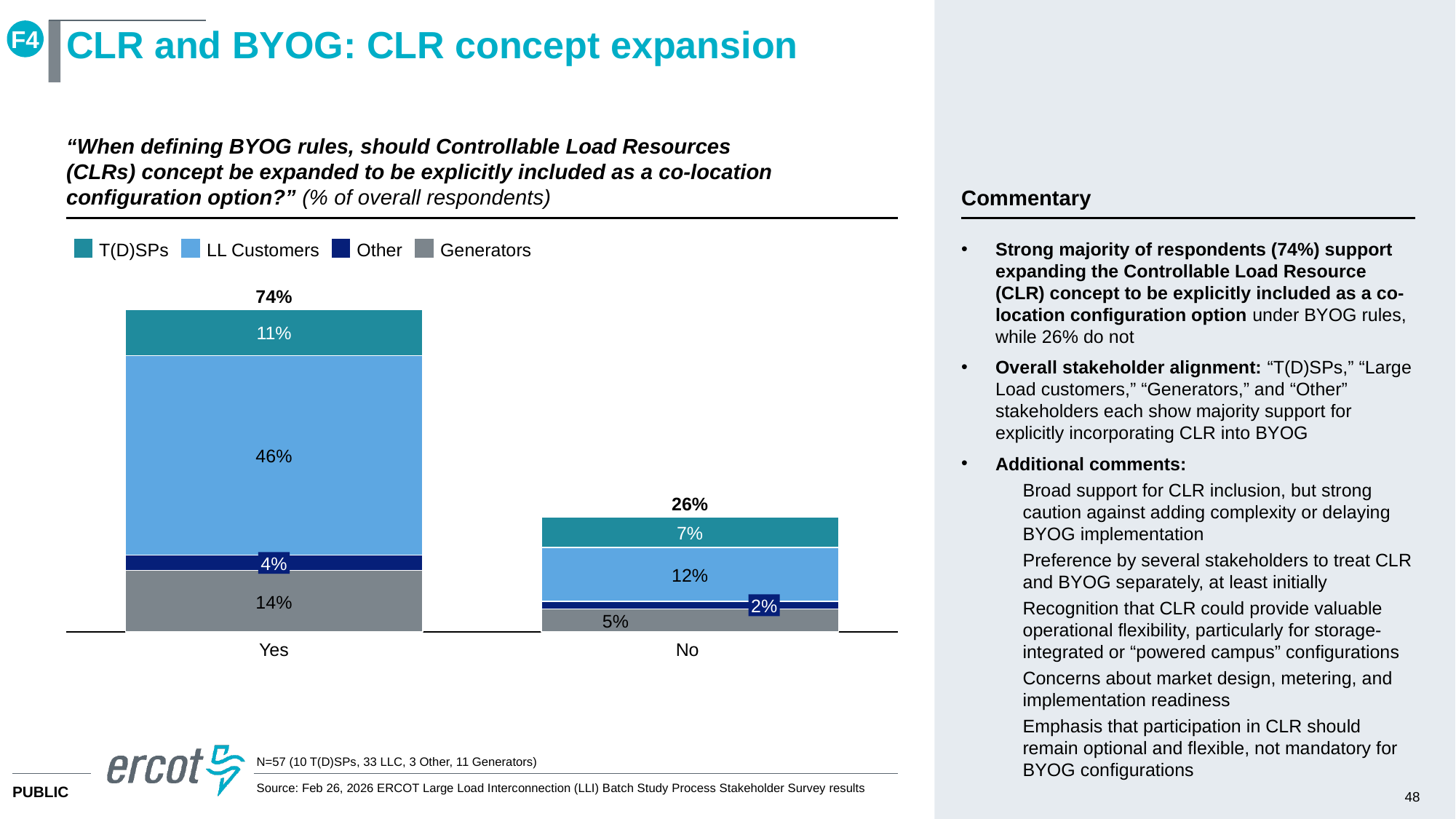
How many response categories are shown on the x axis? 2 How many series does the legend list? 4 What is the T(D)SPs value in the "No" bar? 7% What is the total percentage shown for the "Yes" bar? 74% What kind of chart is shown on the slide? Stacked bar chart Which response category has the higher total, Yes or No? Yes What is the difference between the LL Customers values for Yes and No? 34% Which series is shown in grey in the legend? Generators What is the total percentage shown for the "No" bar? 26% What is the LL Customers value in the "Yes" bar? 46% What is the Generators value in the "Yes" bar? 14% What is the Other value in the "No" bar? 2%